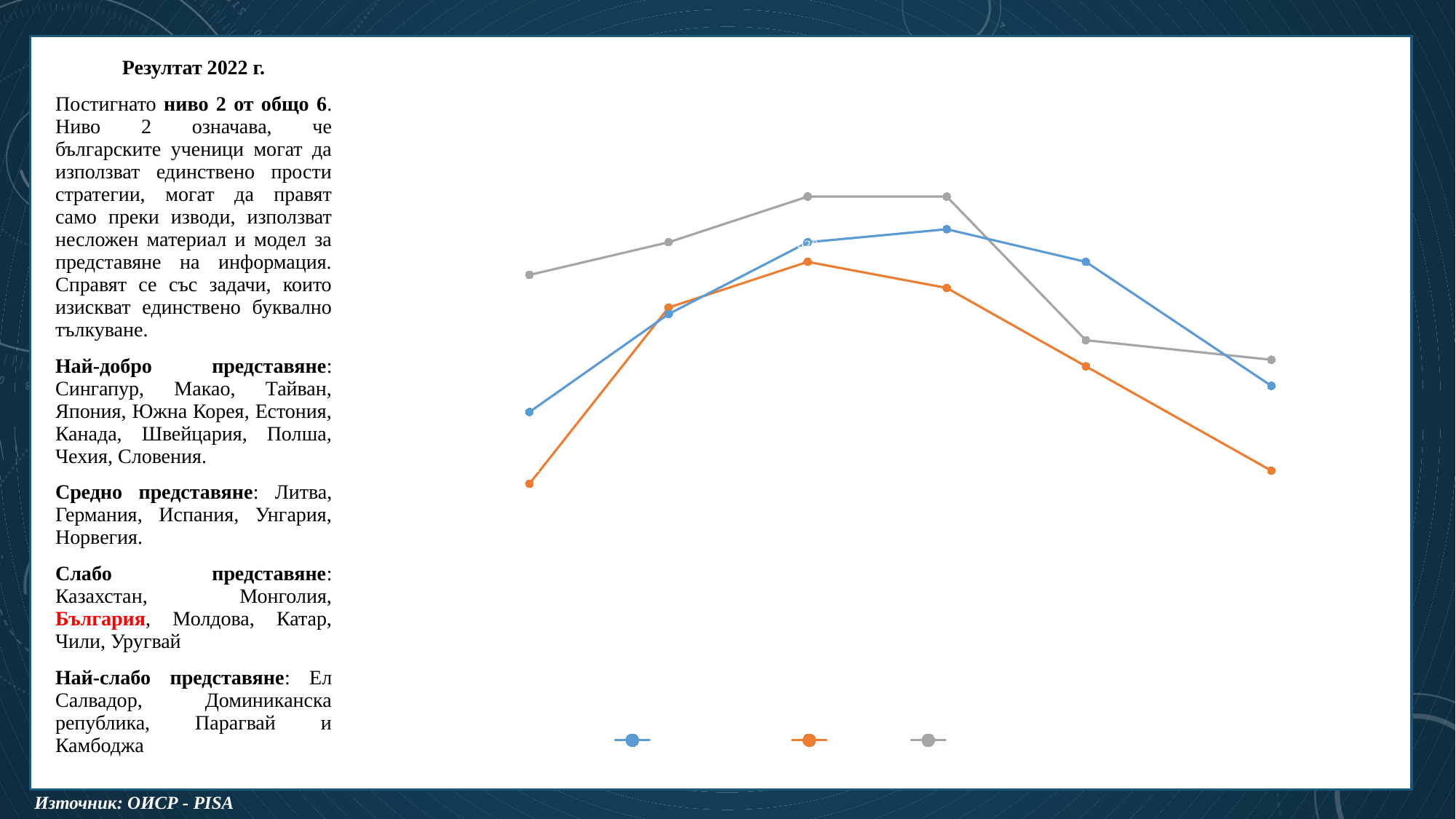
Does the chart show any axis labels or data labels? no At the first point on the x axis, which line is lowest: the blue, orange or grey line? orange Does the blue line rise or fall between its first and second points? rise What colours are the three lines in the chart? blue, orange and grey How many series does the legend of the chart list? 3 How many data points does each line in the chart have? 6 Does the orange line rise or fall between its fifth and sixth points? fall At the last point on the x axis, is the grey line or the orange line higher? grey At the first point on the x axis, which line is highest: the blue, orange or grey line? grey What kind of chart is shown on the slide? line chart